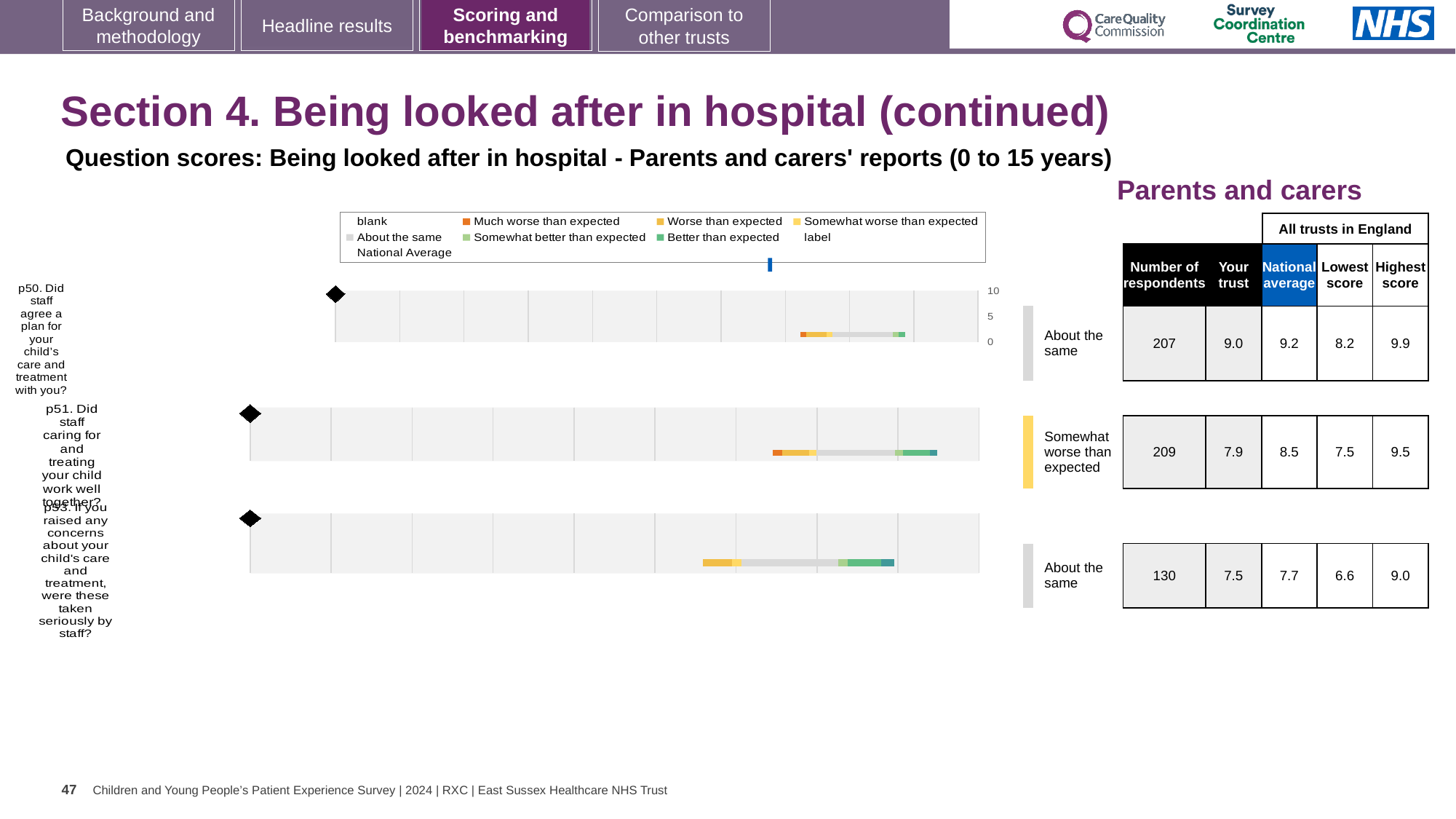
What is the 'Your trust' score for p50 (Did staff agree a plan for your child's care and treatment with you?)? 9.0 Which question has the highest 'Your trust' score on this slide? p50 Which question has the lowest 'Your trust' score on this slide? p53 What is the highest score among all trusts in England for p50? 9.9 What is the national average score for p51 (Did staff caring for and treating your child work well together?)? 8.5 What benchmark category is shown for p51 (Did staff caring for and treating your child work well together?)? Somewhat worse than expected For p50, which is larger: the 'Your trust' score or the national average? National average How many survey questions are charted on this slide? 3 How many respondents answered p53 (If you raised any concerns about your child's care and treatment, were these taken seriously by staff?)? 130 What is the lowest score among all trusts in England for p53? 6.6 What kind of chart is used to show the question scores on this slide? Bar chart For p51, what is the difference between the national average and the 'Your trust' score? 0.6